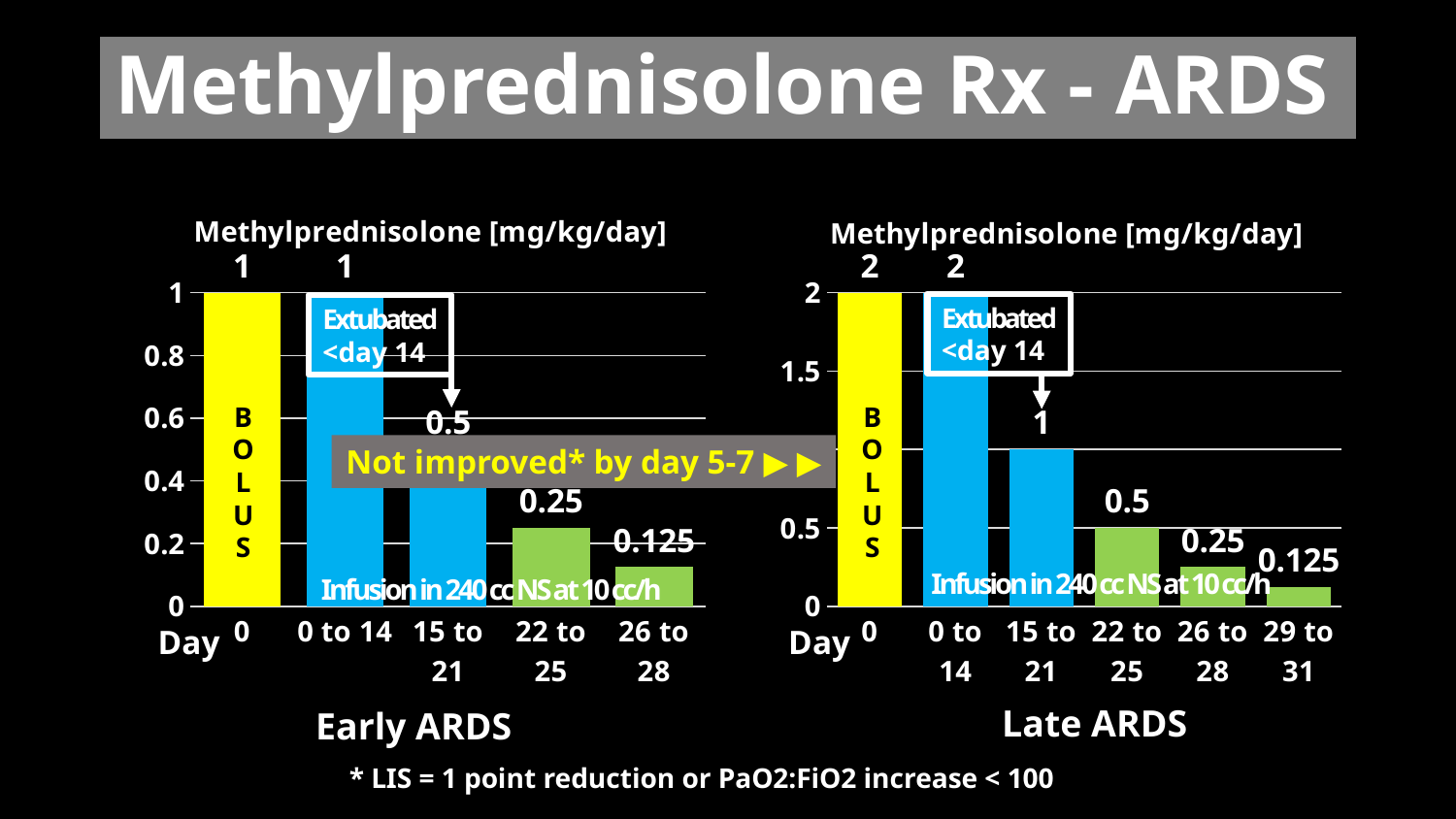
How many day-range categories are shown in the Early ARDS chart? 5 Which is larger: the day 0 bolus dose in the Early ARDS chart or the day 0 bolus dose in the Late ARDS chart? Late ARDS In the Early ARDS chart, what is the difference between the dose for days 0 to 14 and the dose for days 15 to 21? 0.5 In the Late ARDS chart, what is the difference between the dose for days 15 to 21 and the dose for days 22 to 25? 0.5 In the Early ARDS chart, what is the dose for days 26 to 28? 0.125 In the Late ARDS chart, do the doses rise or fall as the day ranges progress from 0 to 14 through 29 to 31? Fall What type of chart is the Early ARDS chart? Bar chart In the Late ARDS chart, what is the methylprednisolone dose for days 22 to 25? 0.5 How many day-range categories are shown in the Late ARDS chart? 6 In the Late ARDS chart, what is the dose for days 0 to 14? 2 In the Late ARDS chart, which day range has the lowest dose? 29 to 31 In the Early ARDS chart, what is the methylprednisolone dose for days 15 to 21? 0.5